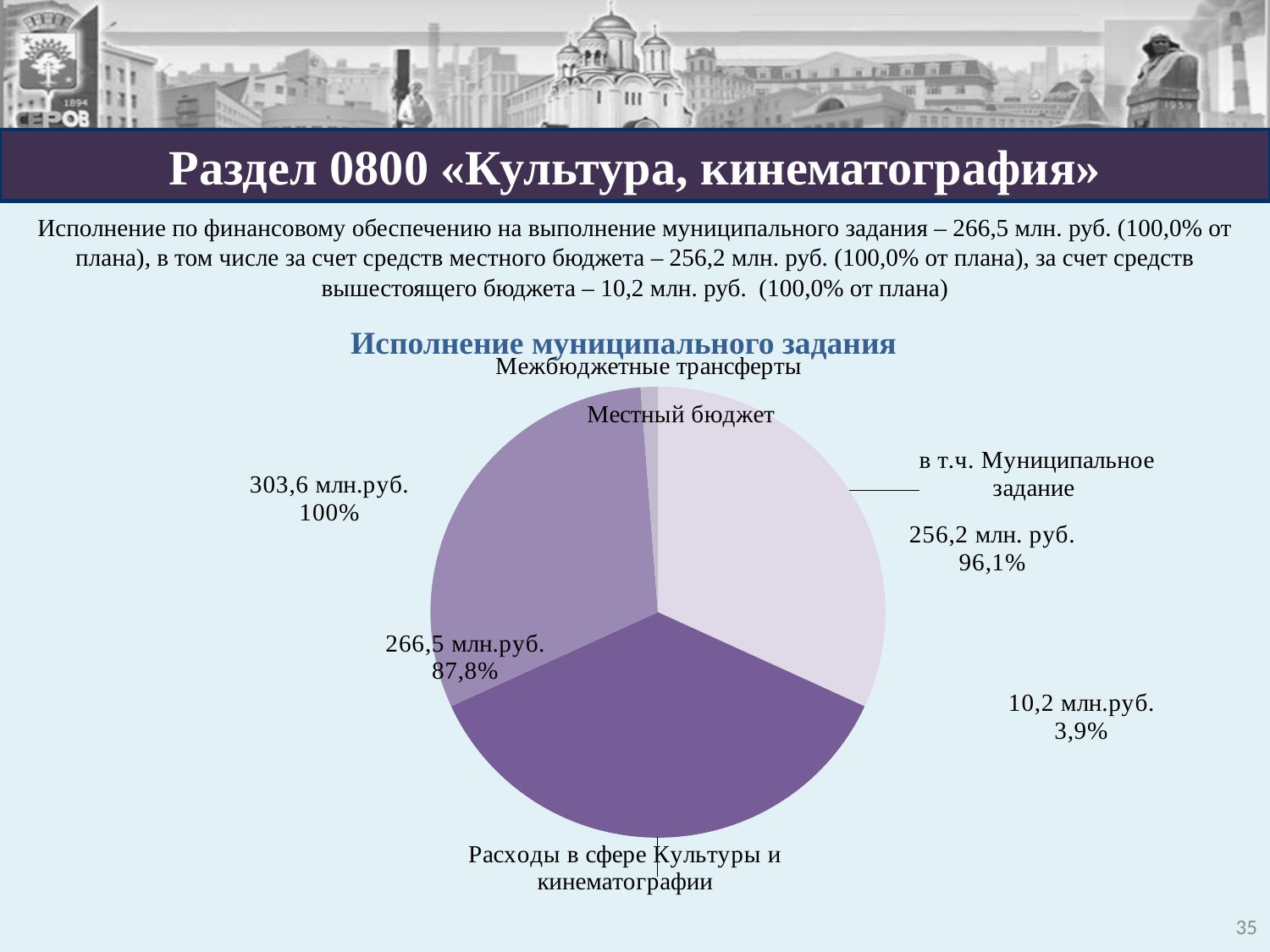
What is the largest value in млн.руб. printed on the chart? 303,6 млн.руб. What is the smallest value in млн.руб. printed on the chart? 10,2 млн.руб. How many slices does the pie chart have? 4 What value in млн. руб. is shown under the label «в т.ч. Муниципальное задание»? 256,2 млн. руб. What kind of chart is shown on the slide? pie chart What percentage is printed next to the value 266,5 млн.руб.? 87,8% What percentage is printed next to the value 303,6 млн.руб.? 100% What percentage is printed next to the value 10,2 млн.руб.? 3,9% What percentage is printed next to the value 256,2 млн. руб.? 96,1% What is the difference between 266,5 млн.руб. and 256,2 млн. руб. shown on the chart? 10,3 млн. руб. Which is larger, the value labelled 256,2 млн. руб. or the value labelled 10,2 млн.руб.? 256,2 млн. руб. What is the title of the chart? Исполнение муниципального задания